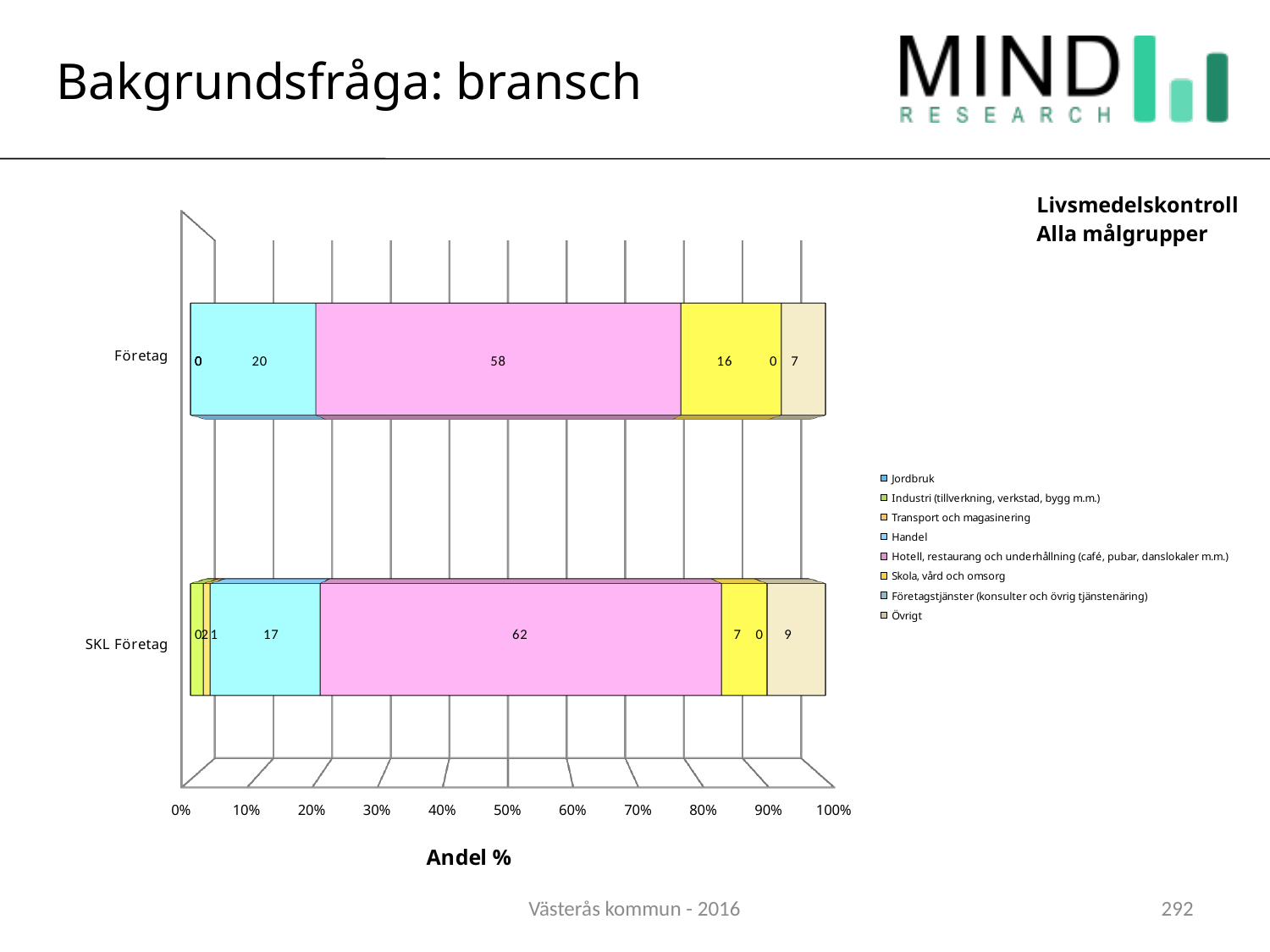
What is the value for Hotell, restaurang och underhållning in the Företag bar? 58 Which bar has the larger Handel value, Företag or SKL Företag? Företag How many series does the legend list? 8 What is the value for Skola, vård och omsorg in the SKL Företag bar? 7 How many bars (categories) are shown in the chart? 2 Which series has the largest segment in the Företag bar? Hotell, restaurang och underhållning (café, pubar, danslokaler m.m.) What is the difference between the Skola, vård och omsorg values for Företag and SKL Företag? 9 What is the value for Industri (tillverkning, verkstad, bygg m.m.) in the SKL Företag bar? 2 What is the value for Hotell, restaurang och underhållning in the SKL Företag bar? 62 What is the value for Övrigt in the SKL Företag bar? 9 What is the value for Handel in the Företag bar? 20 What kind of chart is shown on the slide? Stacked bar chart